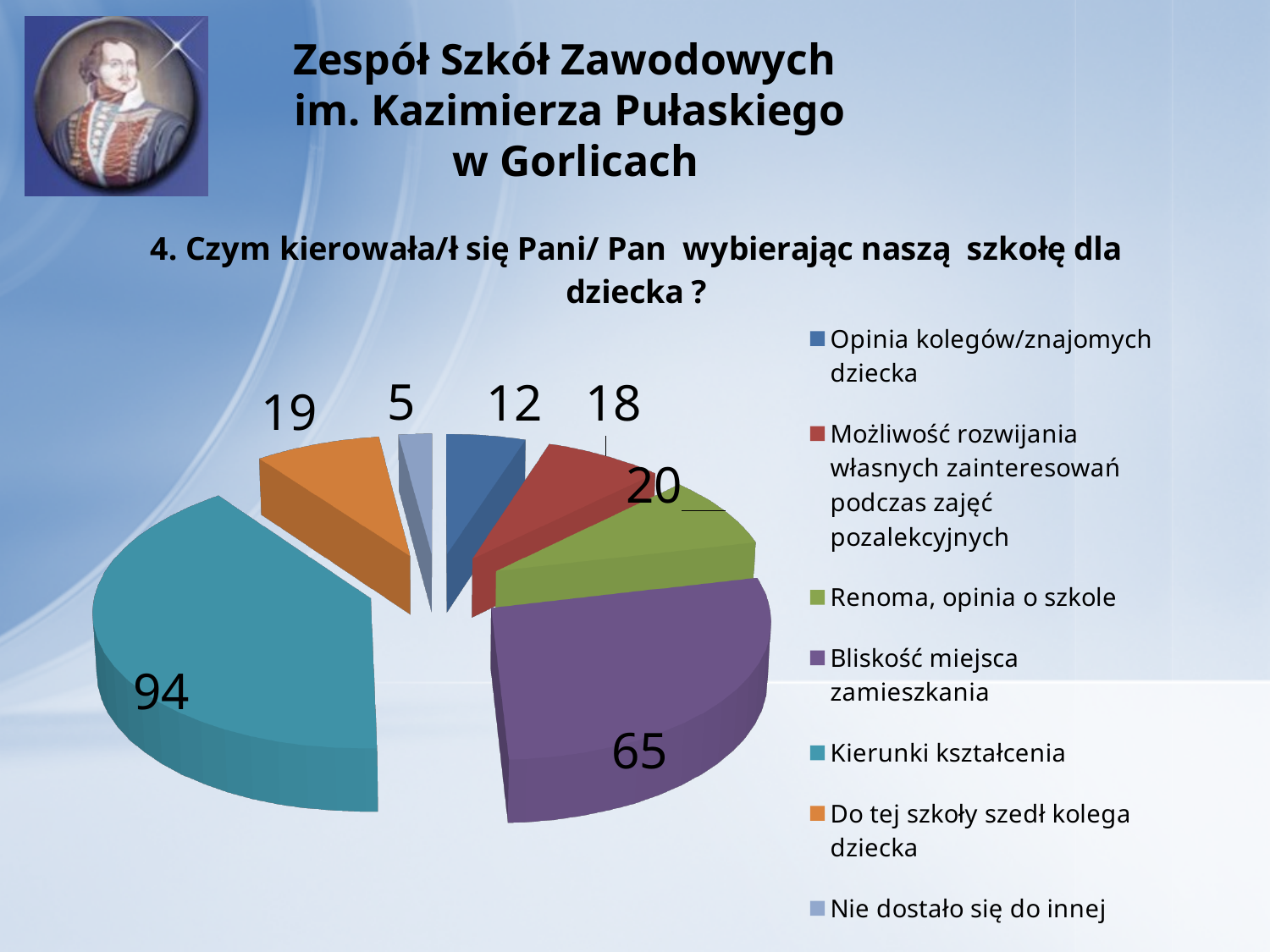
How many categories does the legend of the pie chart list? 7 Which is larger: "Możliwość rozwijania własnych zainteresowań podczas zajęć pozalekcyjnych" or "Opinia kolegów/znajomych dziecka"? Możliwość rozwijania własnych zainteresowań podczas zajęć pozalekcyjnych What is the value for "Bliskość miejsca zamieszkania"? 65 What is the difference between the values for "Kierunki kształcenia" and "Bliskość miejsca zamieszkania"? 29 Which category has the largest slice of the pie? Kierunki kształcenia What is the value for "Do tej szkoły szedł kolega dziecka"? 19 What is the value for "Kierunki kształcenia"? 94 Which category has the smallest slice of the pie? Nie dostało się do innej What kind of chart is shown on the slide? Pie chart What colour is the slice for "Bliskość miejsca zamieszkania"? Purple What is the value for "Nie dostało się do innej"? 5 What is the value for "Renoma, opinia o szkole"? 20